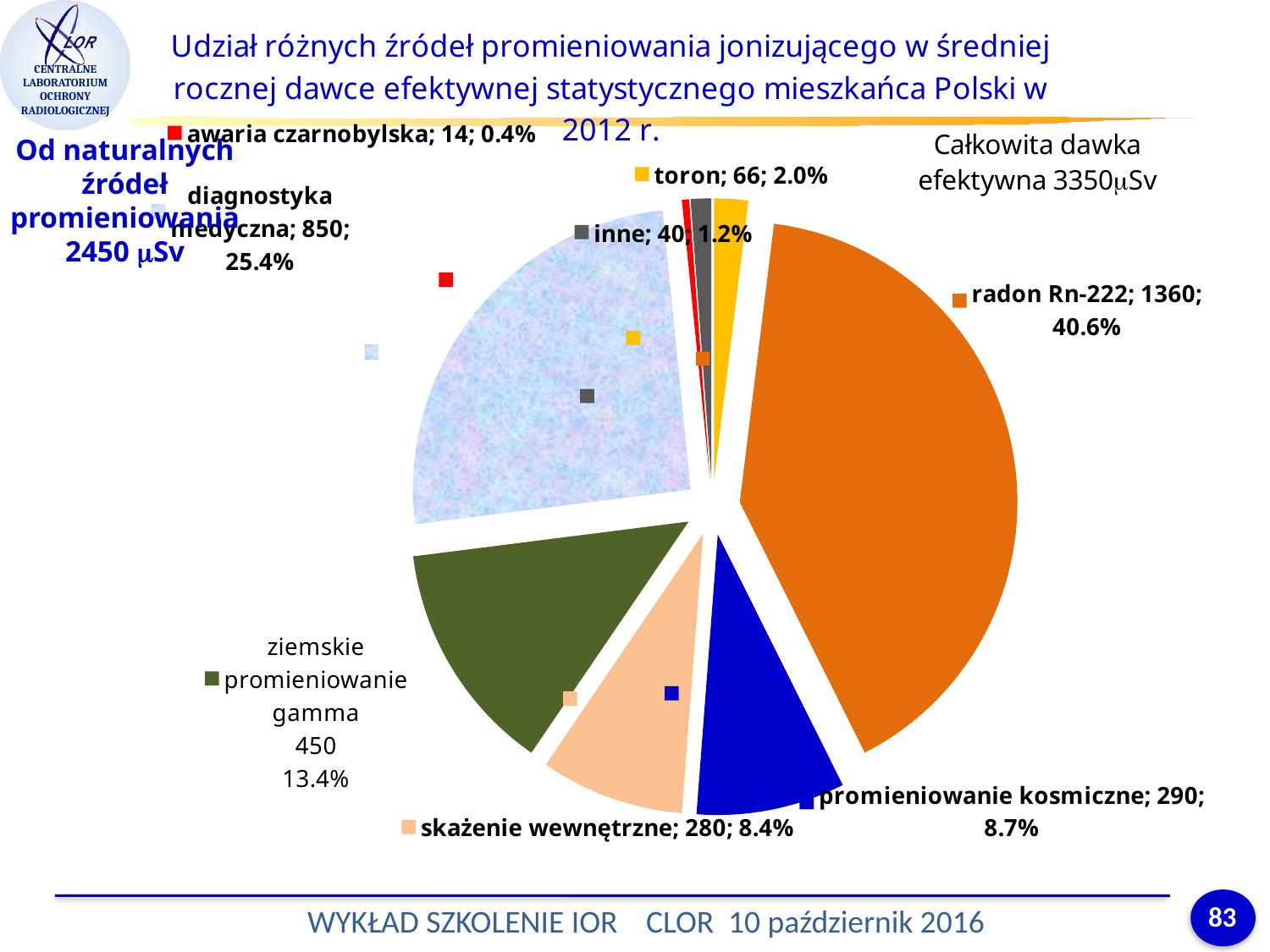
What percentage share is shown for ziemskie promieniowanie gamma? 13.4% What percentage share is shown for diagnostyka medyczna? 25.4% Which category has the largest slice of the pie? radon Rn-222 What value is shown for toron? 66 What percentage share is shown for promieniowanie kosmiczne? 8.7% What total effective dose (Całkowita dawka efektywna) is stated on the slide? 3350 µSv What value is shown for radon Rn-222? 1360 What kind of chart is shown on the slide? pie chart How many slices does the pie chart have? 8 What is the difference between the values for promieniowanie kosmiczne and skażenie wewnętrzne? 10 Which category has the smallest slice of the pie? awaria czarnobylska Which is larger, the value for inne or the value for toron? toron